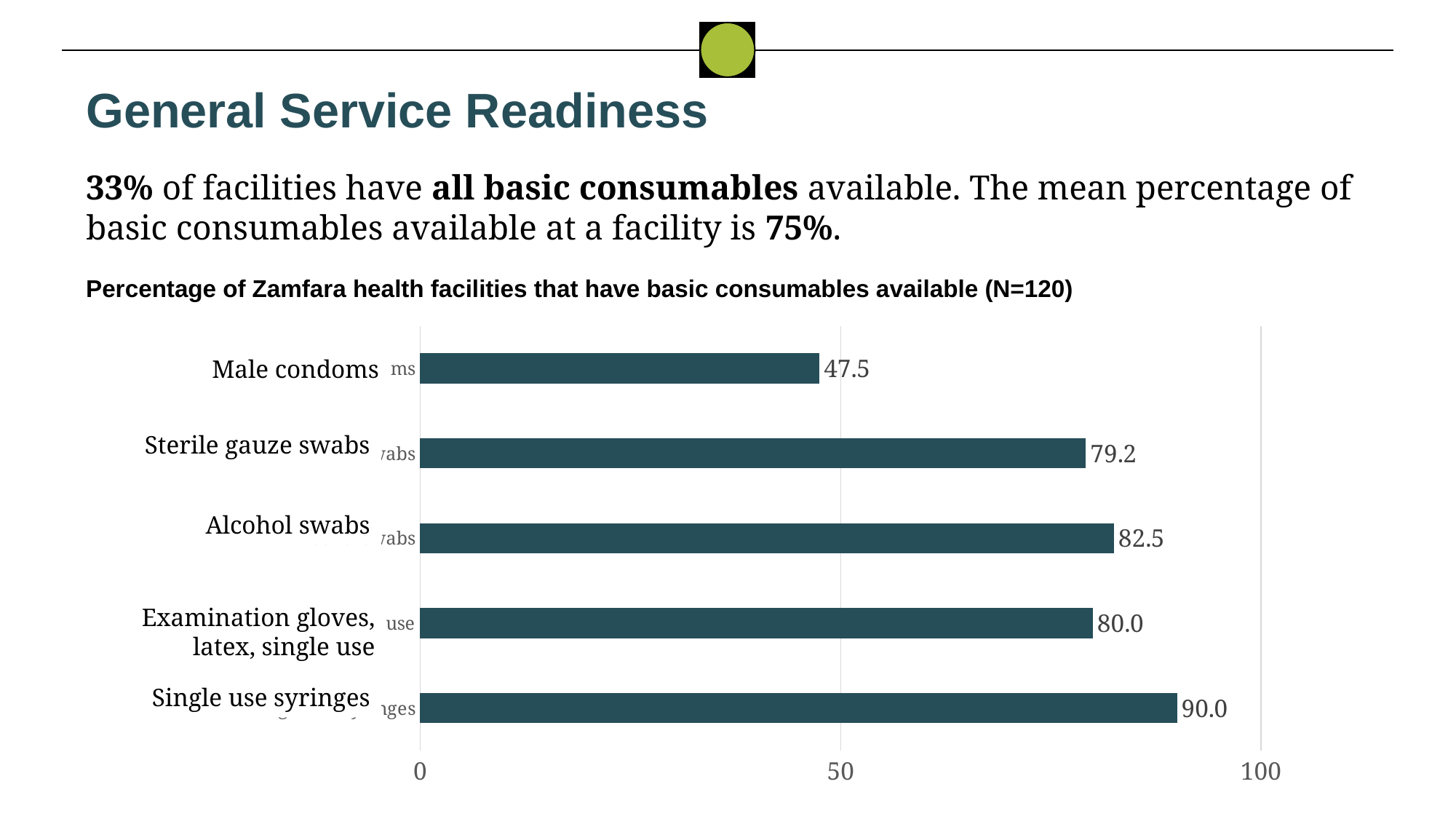
What is the difference between the values for Single use syringes and Male condoms? 42.5 What percentage of Zamfara health facilities have male condoms available? 47.5 Which basic consumable has the highest percentage of facilities with it available? Single use syringes Which has a higher value, Alcohol swabs or Examination gloves, latex, single use? Alcohol swabs How many basic consumables are shown in the chart? 5 Is the value for Male condoms greater or less than 50? less What kind of chart is shown on the slide? Bar chart What is the value shown for Alcohol swabs? 82.5 What is the value shown for Single use syringes? 90.0 What is the difference between the values for Alcohol swabs and Sterile gauze swabs? 3.3 Which basic consumable has the lowest percentage of facilities with it available? Male condoms What is the value shown for Examination gloves, latex, single use? 80.0